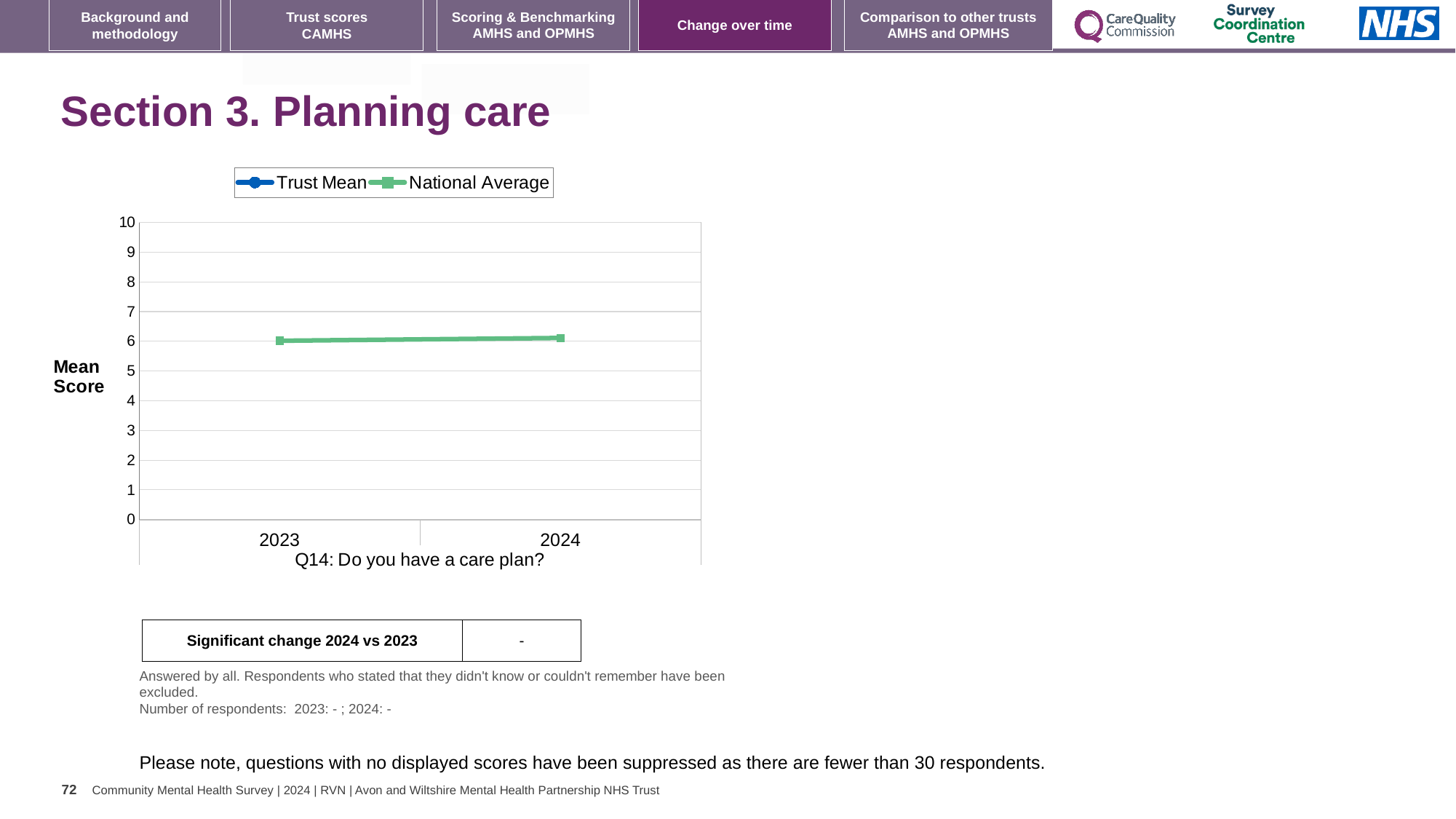
Which years are shown on the x axis of the chart? 2023 and 2024 Is the National Average value for 2024 greater or less than 5? greater What kind of chart is shown on the slide? line chart Is the National Average value for 2023 greater or less than 5? greater Is the National Average value for 2023 greater or less than 7? less How many years are shown on the x axis of the chart? 2 What is the highest value shown on the y axis of the chart? 10 How many series does the chart legend list? 2 What are the two series named in the chart legend? Trust Mean and National Average